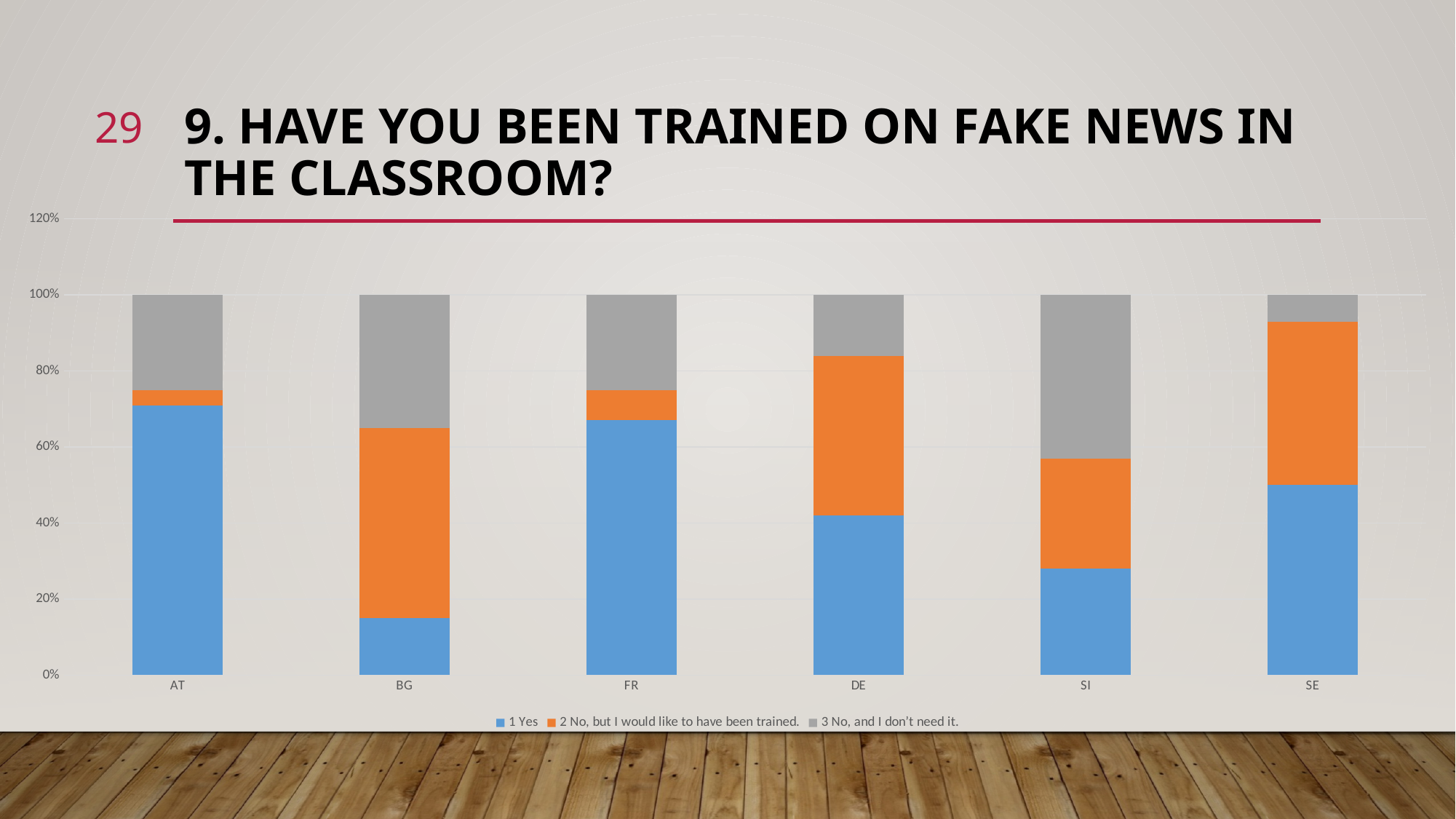
What is the total height of the stacked bar for DE? 100% How many series does the chart's legend list? 3 Which country has the highest share of '1 Yes' responses? AT What kind of chart is shown on the slide? Stacked bar chart Which country has a larger '1 Yes' share, AT or BG? AT Which country has the smallest share of '3 No, and I don't need it.' responses? SE Is the '1 Yes' value for AT greater or less than 60%? greater Which country has the largest share of '3 No, and I don't need it.' responses? SI Which country has the lowest share of '1 Yes' responses? BG Is the '1 Yes' value for BG greater or less than 20%? less Is the '1 Yes' value for SI greater or less than 40%? less How many countries are shown on the x axis of the chart? 6